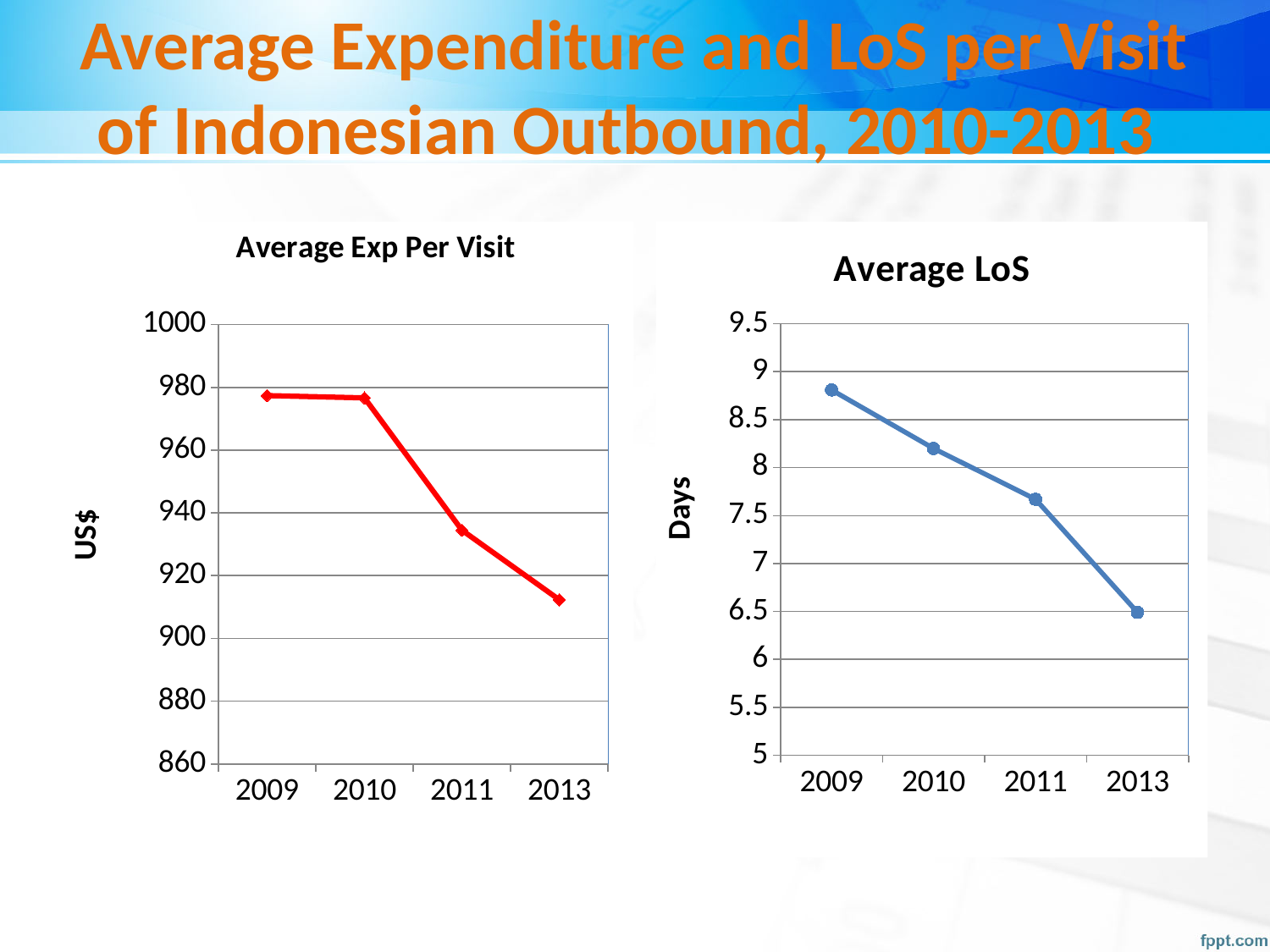
What is the y-axis title of the "Average LoS" chart? Days How many data points are plotted on the "Average LoS" chart? 4 On the "Average LoS" chart, do the values rise or fall from 2009 to 2013? fall What kind of chart is the "Average Exp Per Visit" chart? line chart On the "Average Exp Per Visit" chart, do the values rise or fall from 2009 to 2013? fall On the "Average LoS" chart, which year has the highest value? 2009 What kind of chart is the "Average LoS" chart? line chart On the "Average Exp Per Visit" chart, is the value for 2011 greater or less than 940? less On the "Average LoS" chart, is the value for 2010 greater or less than 8? greater On the "Average LoS" chart, which year has the lowest value? 2013 On the "Average Exp Per Visit" chart, which year has the lowest value? 2013 How many years are plotted on the "Average Exp Per Visit" chart? 4